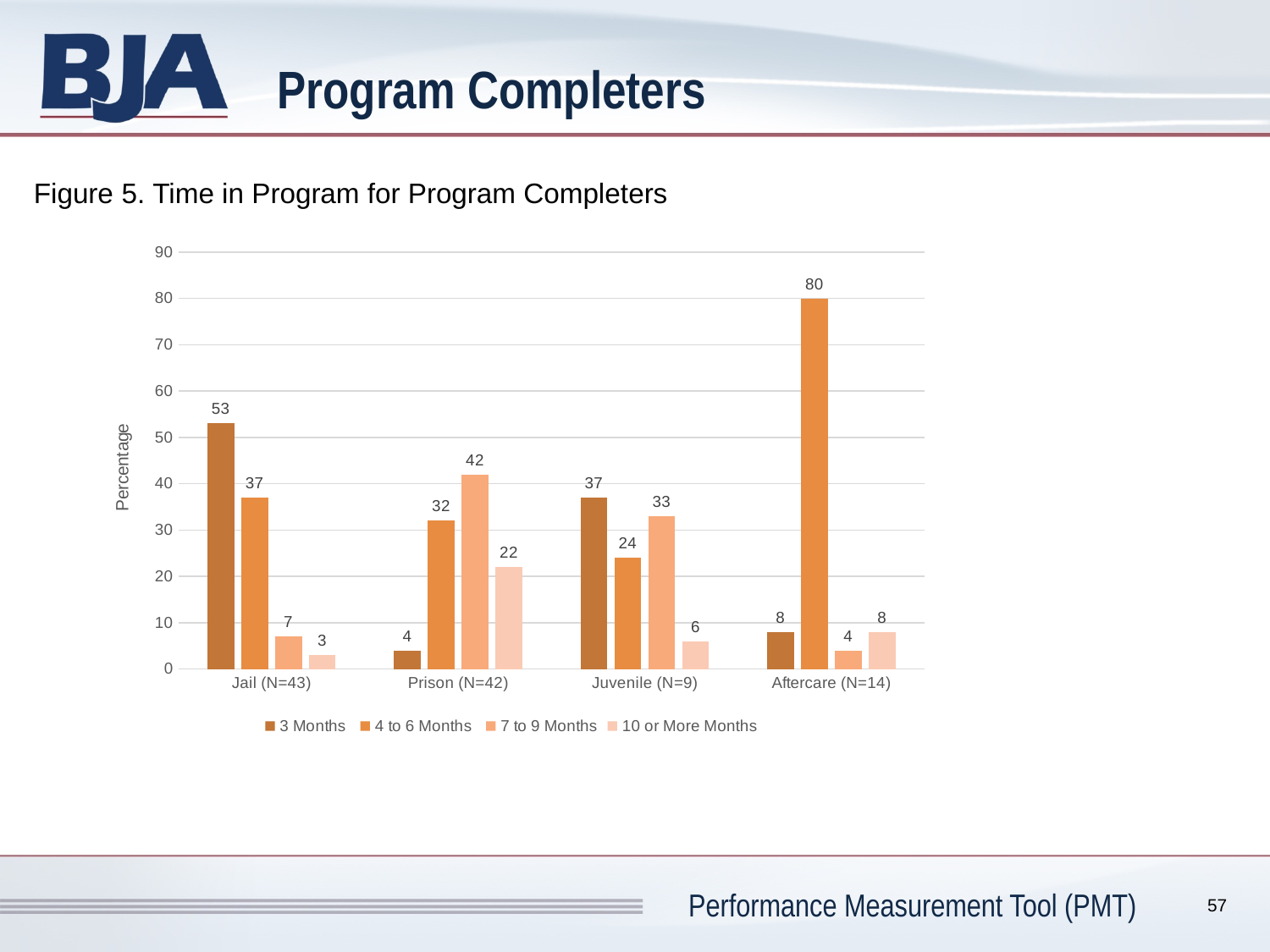
Which category has the lowest value for 3 Months? Prison (N=42) What is the value for 7 to 9 Months in the Prison (N=42) category? 42 Which is larger in the Juvenile (N=9) category: the 3 Months value or the 7 to 9 Months value? 3 Months What is the value for 10 or More Months in the Juvenile (N=9) category? 6 What is the difference between the 3 Months value and the 4 to 6 Months value in the Jail (N=43) category? 16 Is the value for 7 to 9 Months in the Juvenile (N=9) category greater or less than 30? greater How many series does the legend list? 4 What is the value for 4 to 6 Months in the Aftercare (N=14) category? 80 What kind of chart is shown on the slide? Bar chart What is the value for 3 Months in the Jail (N=43) category? 53 Which category has the highest value for 4 to 6 Months? Aftercare (N=14) How many categories are shown on the x axis? 4